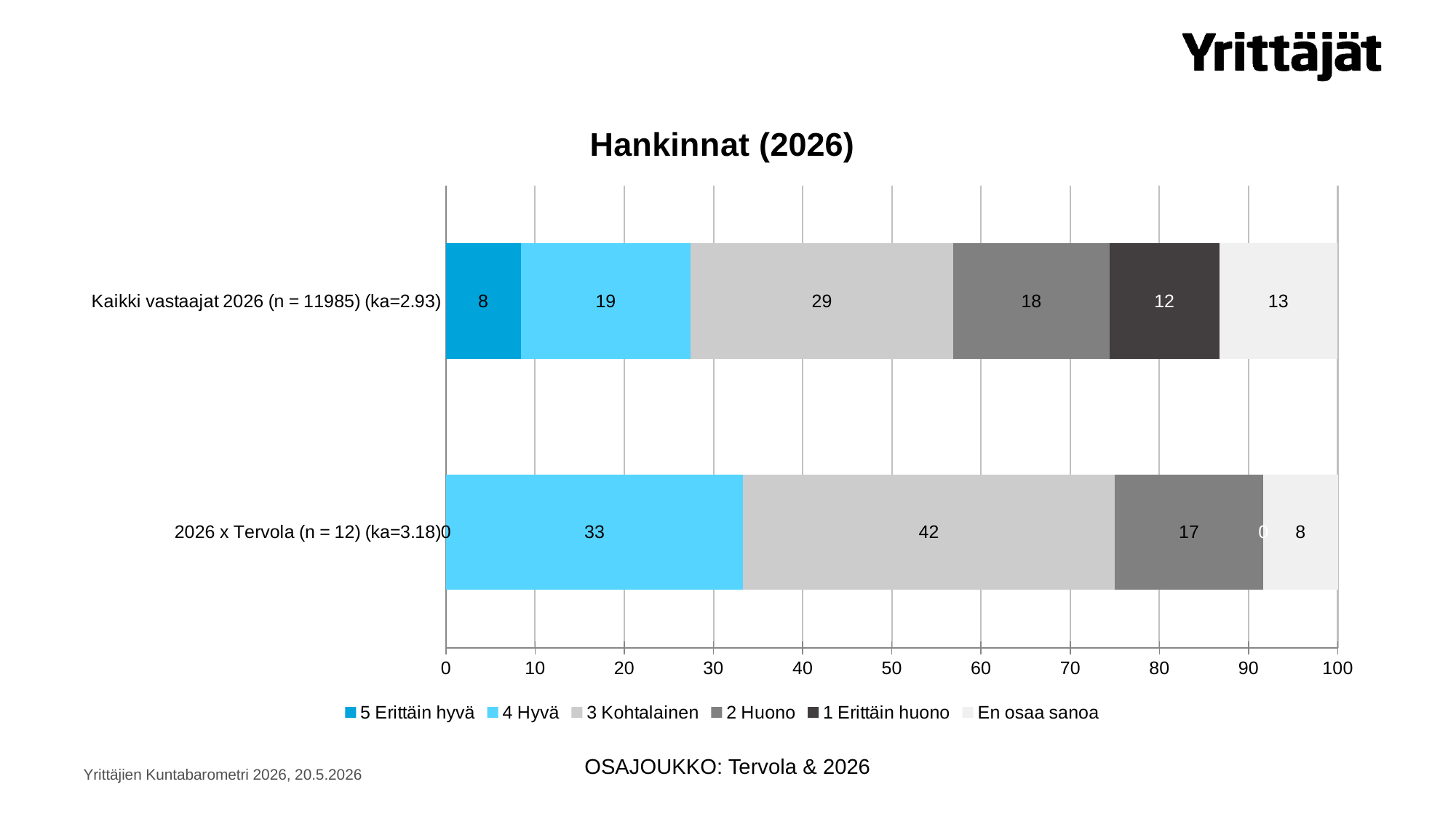
What is the difference between the "3 Kohtalainen" values of the two bars? 13 How many bars (categories) are shown in the chart? 2 What is the value for "En osaa sanoa" in the "Kaikki vastaajat 2026 (n = 11985) (ka=2.93)" bar? 13 Which bar has the larger value for "2 Huono"? Kaikki vastaajat 2026 (n = 11985) (ka=2.93) What kind of chart is shown on the slide? Stacked bar chart Which series has the smallest value in the "Kaikki vastaajat 2026 (n = 11985) (ka=2.93)" bar? 5 Erittäin hyvä Which series has the largest value in the "2026 x Tervola (n = 12) (ka=3.18)" bar? 3 Kohtalainen What is the title of the chart? Hankinnat (2026) What is the value for "4 Hyvä" in the "2026 x Tervola (n = 12) (ka=3.18)" bar? 33 How many series does the legend list? 6 What is the value for "1 Erittäin huono" in the "2026 x Tervola (n = 12) (ka=3.18)" bar? 0 What is the value for "3 Kohtalainen" in the "Kaikki vastaajat 2026 (n = 11985) (ka=2.93)" bar? 29